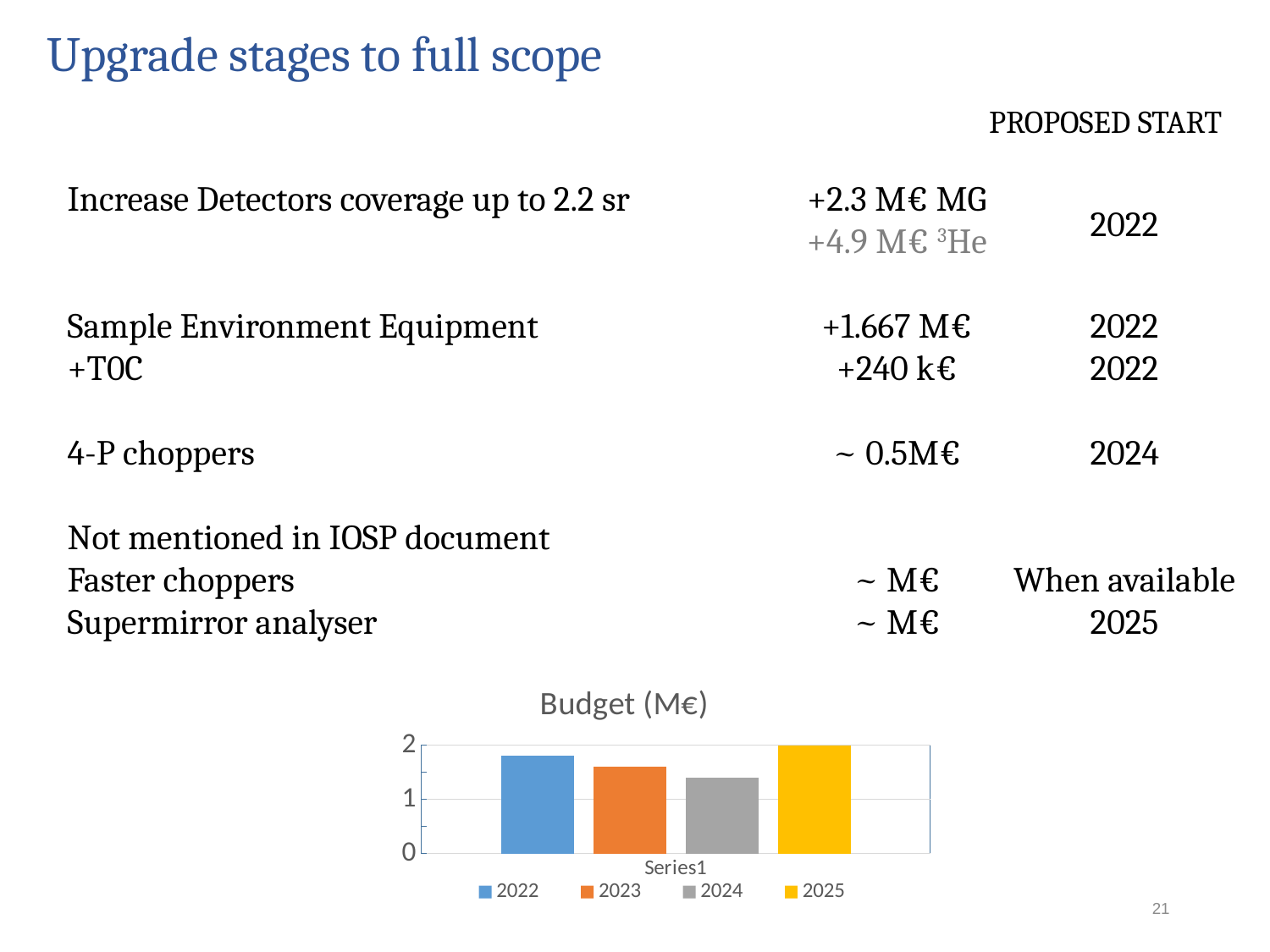
Is the budget bar for 2024 greater or less than 2? less Is the budget bar for 2022 greater or less than 1? greater How many series does the chart legend list? 4 What is the highest value shown on the chart's y axis? 2 What is the title of the chart? Budget (M€) Is the budget bar for 2023 greater or less than 1? greater What is the label on the x axis category under the bars? Series1 Which year has the highest budget bar in the chart? 2025 Which has the larger budget bar, 2022 or 2024? 2022 What kind of chart is shown on the slide? bar chart Which has the larger budget bar, 2025 or 2023? 2025 Which year has the lowest budget bar in the chart? 2024